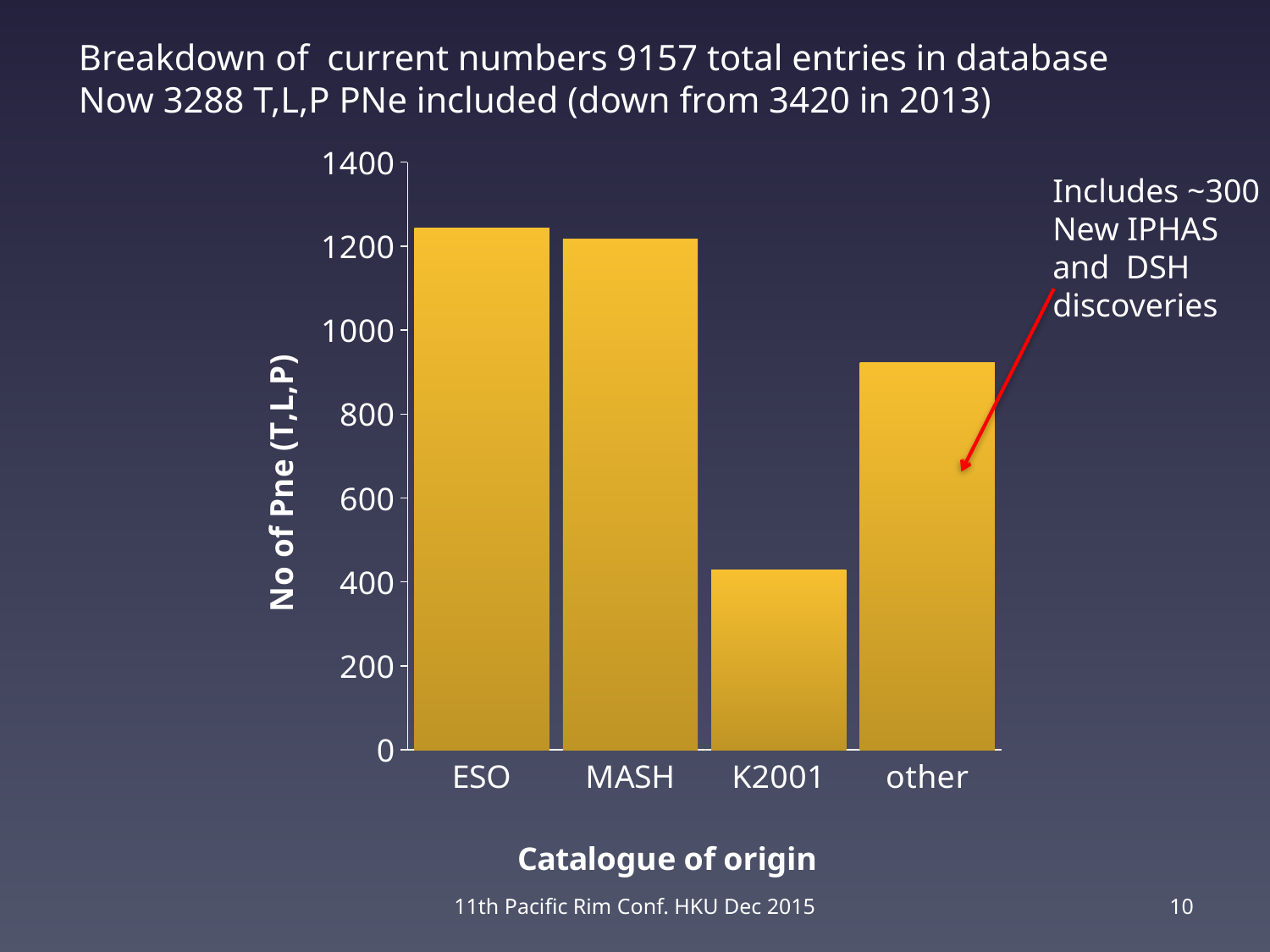
Which has a larger value, MASH or other? MASH Is the value for other greater or less than 800? greater Which has a larger value, K2001 or other? other Is the value for MASH greater or less than 1000? greater How many catalogue categories are shown on the x axis of the chart? 4 What is the title of the horizontal axis of the chart? Catalogue of origin What is the title of the vertical axis of the chart? No of Pne (T,L,P) Is the value for K2001 greater or less than 600? less Which catalogue of origin has the lowest number of PNe in the chart? K2001 What kind of chart is shown on the slide? bar chart